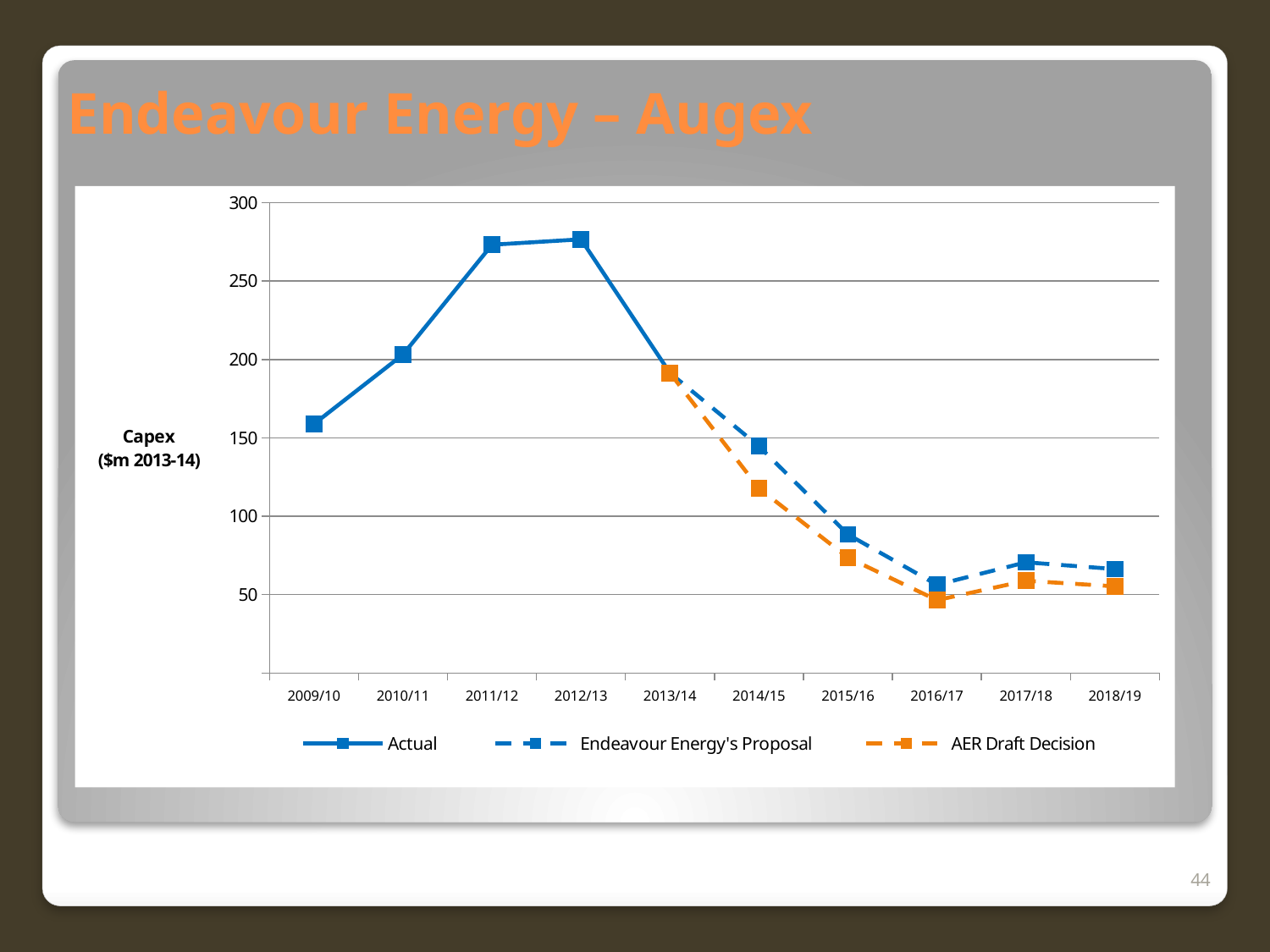
In 2014/15, which is larger: Endeavour Energy's Proposal or the AER Draft Decision? Endeavour Energy's Proposal Do the Actual values rise or fall from 2009/10 to 2012/13? rise Is the Endeavour Energy's Proposal value for 2015/16 greater or less than 100? less What kind of chart is shown on the slide? line chart Is the AER Draft Decision value for 2014/15 greater or less than 100? greater Which year has the lowest Actual value? 2009/10 How many series does the legend list? 3 Is the Actual value for 2009/10 greater or less than 150? greater How many years are shown on the x axis? 10 Which series are listed in the legend? Actual, Endeavour Energy's Proposal, AER Draft Decision What is the label on the vertical axis? Capex ($m 2013-14)